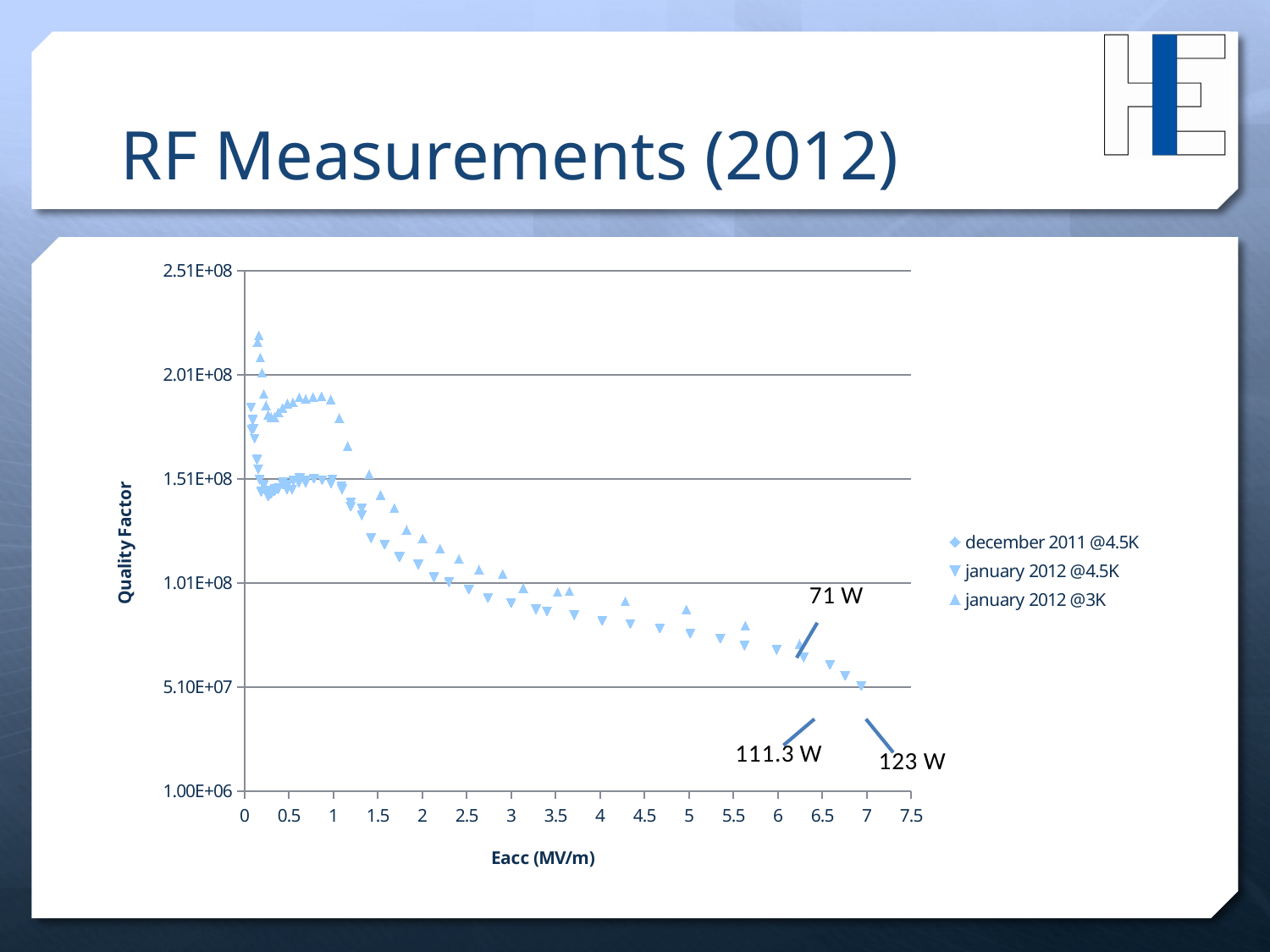
What power value is annotated next to the last data point near Eacc 7? 123 W Is the highest value of the january 2012 @3K series greater or less than 2.01E+08? greater What kind of chart is shown on the slide? scatter chart What is the highest tick value shown on the Quality Factor axis? 2.51E+08 What is the label of the x axis? Eacc (MV/m) At Eacc 1 MV/m, which series has the higher Quality Factor, january 2012 @3K or january 2012 @4.5K? january 2012 @3K What is the title of the slide containing the chart? RF Measurements (2012) How many series does the legend list? 3 Is the value of the january 2012 @4.5K series at Eacc 0.5 greater or less than 1.01E+08? greater Do the Quality Factor values generally rise or fall as Eacc increases beyond 1 MV/m? fall Is the value of the january 2012 @4.5K series at Eacc 7 greater or less than 1.01E+08? less What is the highest tick value shown on the x axis? 7.5